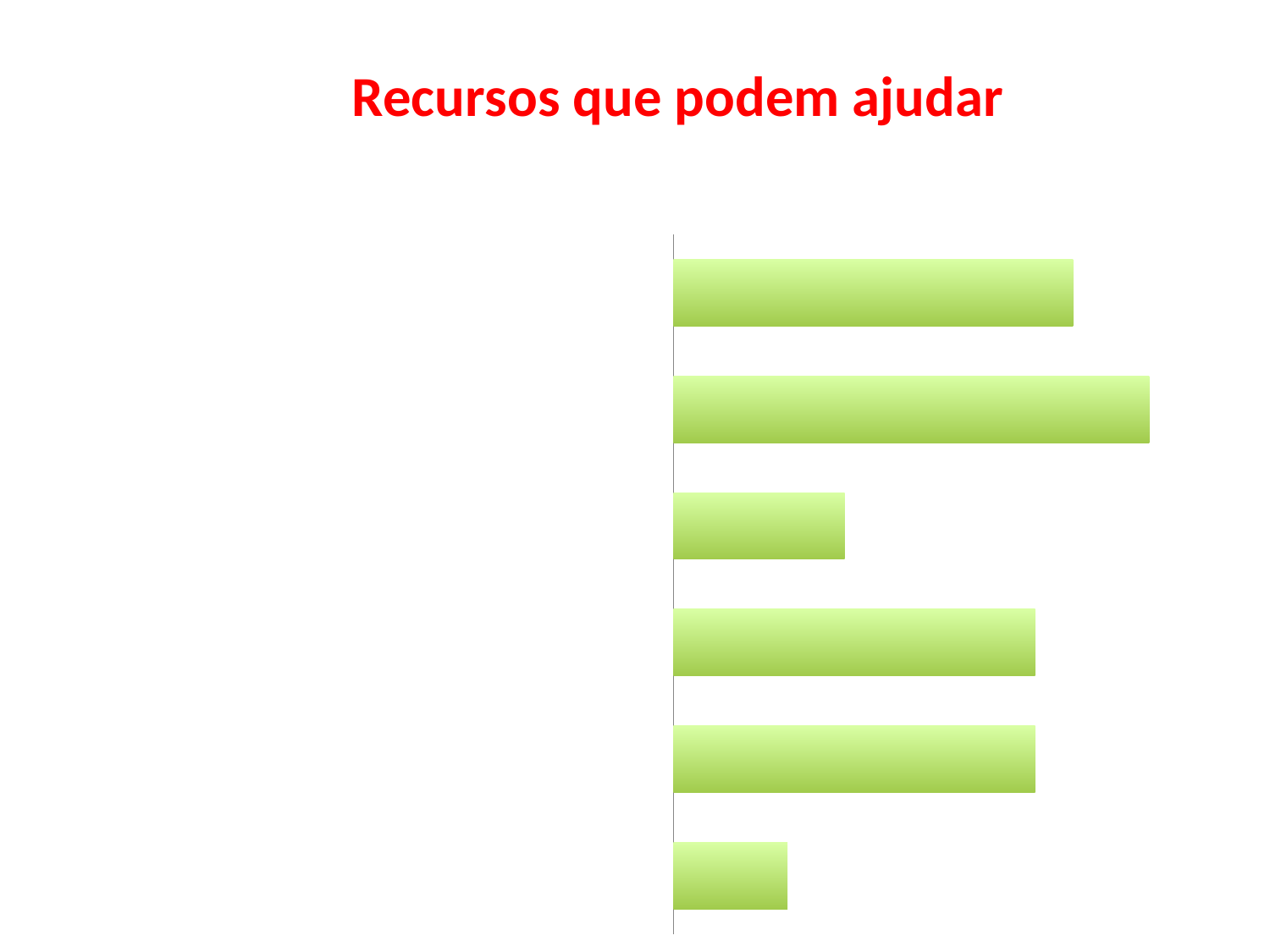
Which is longer: the second bar from the top or the fourth bar from the top? the second bar from the top Counting from the top, which bar is the longest in the chart? the second bar Which is longer: the third bar from the top or the bottom bar? the third bar from the top Which is longer: the top bar or the third bar from the top? the top bar What is the title of the slide containing the chart? Recursos que podem ajudar Are the bars in the chart horizontal or vertical? horizontal What kind of chart is shown on the slide? bar chart How many bars does the chart show? 6 Counting from the top, which bar is the shortest in the chart? the sixth (bottom) bar